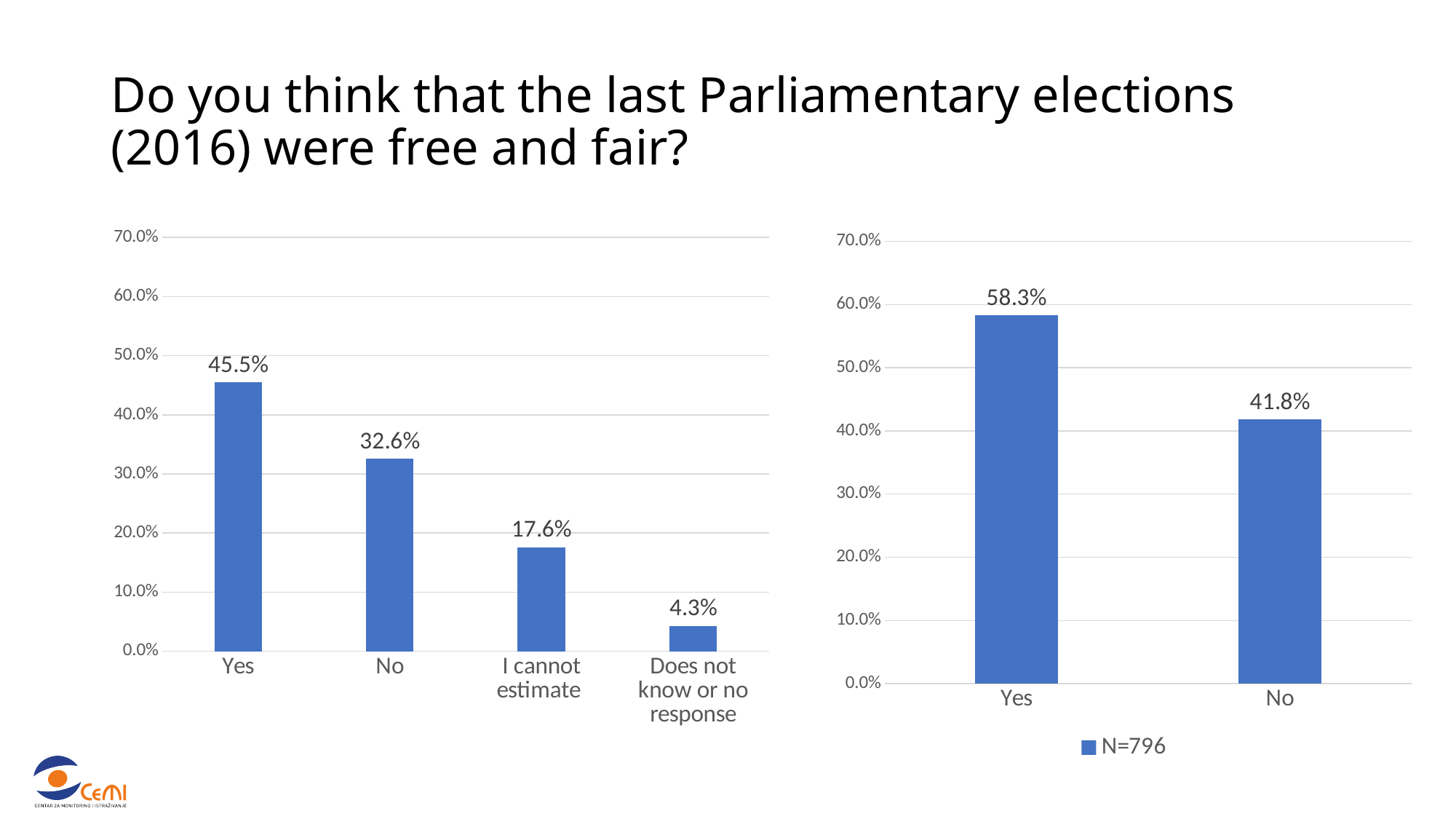
In the right chart, what is the value for "No"? 41.8% What does the legend of the right chart say? N=796 In the left chart, what is the value for "Does not know or no response"? 4.3% In the left chart, which category has the highest value? Yes In the left chart, what is the difference between the values for "Yes" and "No"? 12.9% In the right chart, which is larger, the value for "Yes" or the value for "No"? Yes In the left chart, what is the value for "I cannot estimate"? 17.6% How many categories are shown in the left chart? 4 In the left chart, what is the value for "Yes"? 45.5% In the right chart, what is the difference between the values for "Yes" and "No"? 16.5% What kind of chart is the right chart? bar chart In the left chart, which category has the lowest value? Does not know or no response